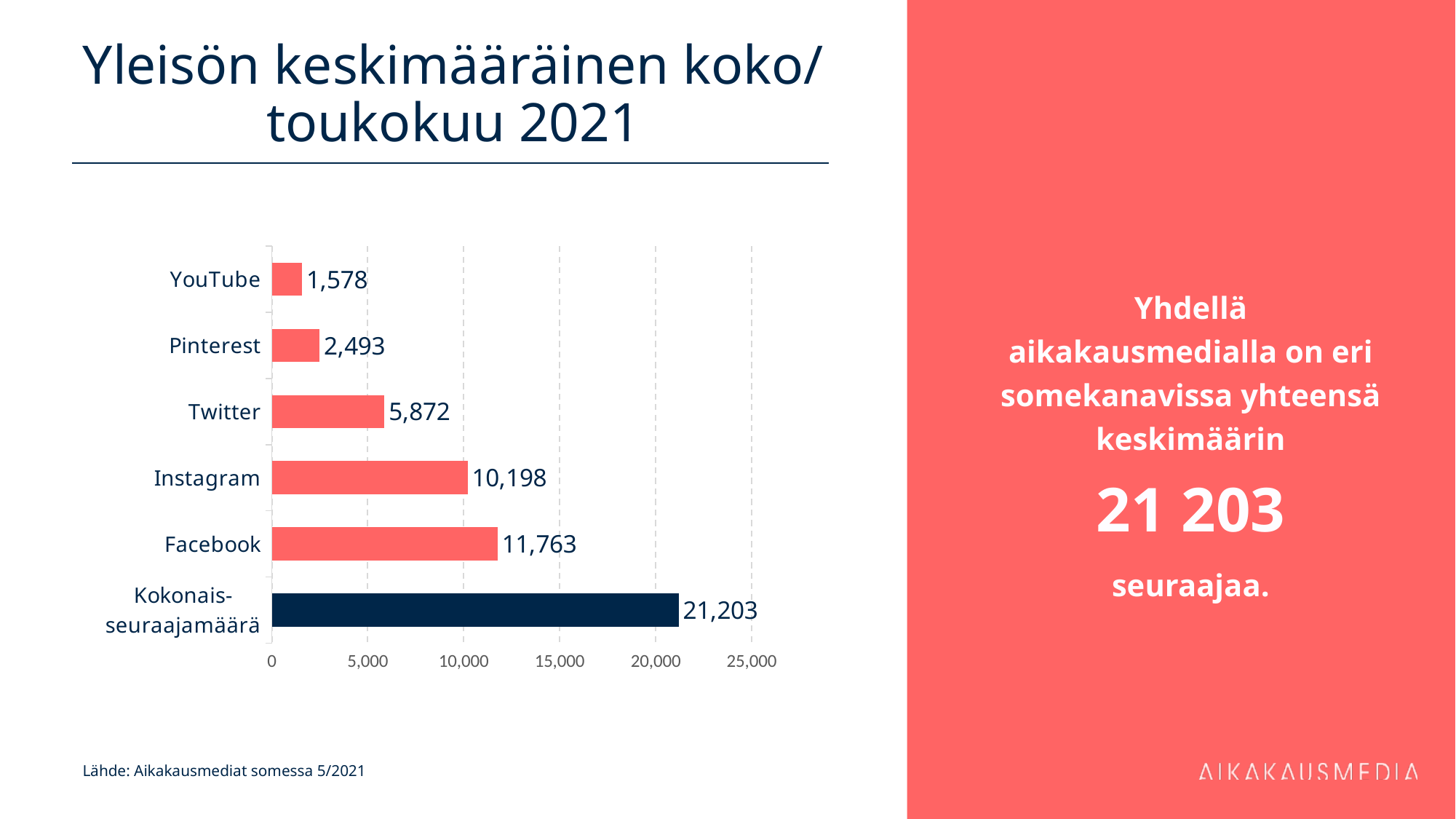
What is the value for Instagram? 10,198 Which category has the lowest value? YouTube What kind of chart is shown on the slide? Bar chart Is the value for Instagram greater or less than 10,000? greater What is the value for Facebook? 11,763 What is the difference between the values for Twitter and Pinterest? 3,379 Which is larger, the value for Twitter or the value for Pinterest? Twitter What is the difference between the values for Facebook and Instagram? 1,565 What is the value for YouTube? 1,578 Which individual social media channel (excluding the total) has the highest value? Facebook What is the value for Kokonais-seuraajamäärä? 21,203 How many categories are shown in the chart? 6